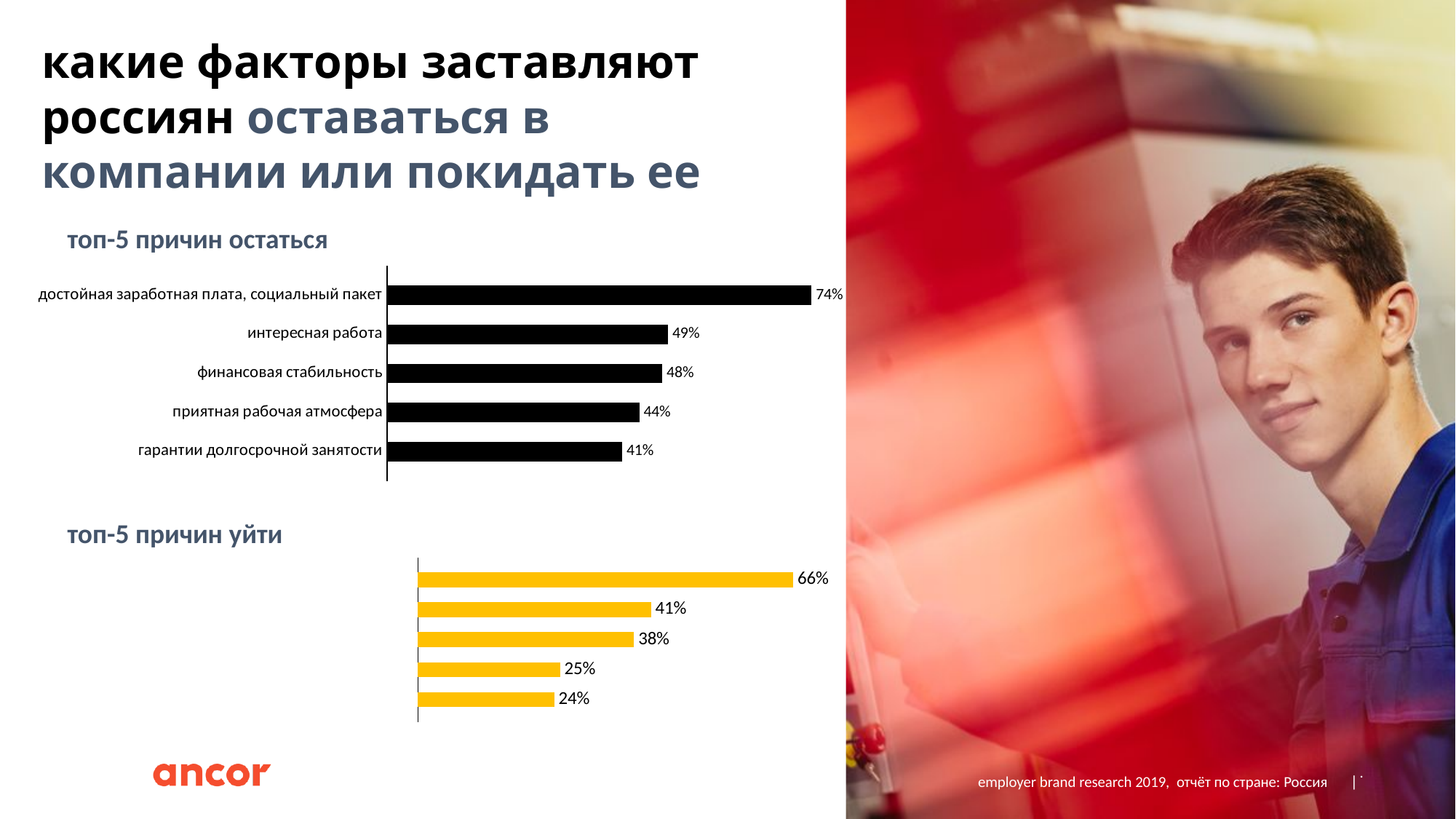
In the 'топ-5 причин остаться' chart, what is the value for 'приятная рабочая атмосфера'? 44% What colour are the bars in the 'топ-5 причин уйти' chart? yellow In the 'топ-5 причин остаться' chart, which is larger: 'финансовая стабильность' or 'приятная рабочая атмосфера'? финансовая стабильность In the 'топ-5 причин остаться' chart, what is the value for 'достойная заработная плата, социальный пакет'? 74% What kind of chart is the 'топ-5 причин уйти' chart? bar chart How many categories are shown in the 'топ-5 причин остаться' chart? 5 In the 'топ-5 причин остаться' chart, which category has the highest value? достойная заработная плата, социальный пакет In the 'топ-5 причин уйти' chart, what is the value of the bottom (shortest) bar? 24% In the 'топ-5 причин остаться' chart, what is the value for 'гарантии долгосрочной занятости'? 41% In the 'топ-5 причин уйти' chart, what is the value of the top (longest) bar? 66% In the 'топ-5 причин остаться' chart, which category has the lowest value? гарантии долгосрочной занятости In the 'топ-5 причин остаться' chart, what is the difference between 'достойная заработная плата, социальный пакет' and 'интересная работа'? 25%